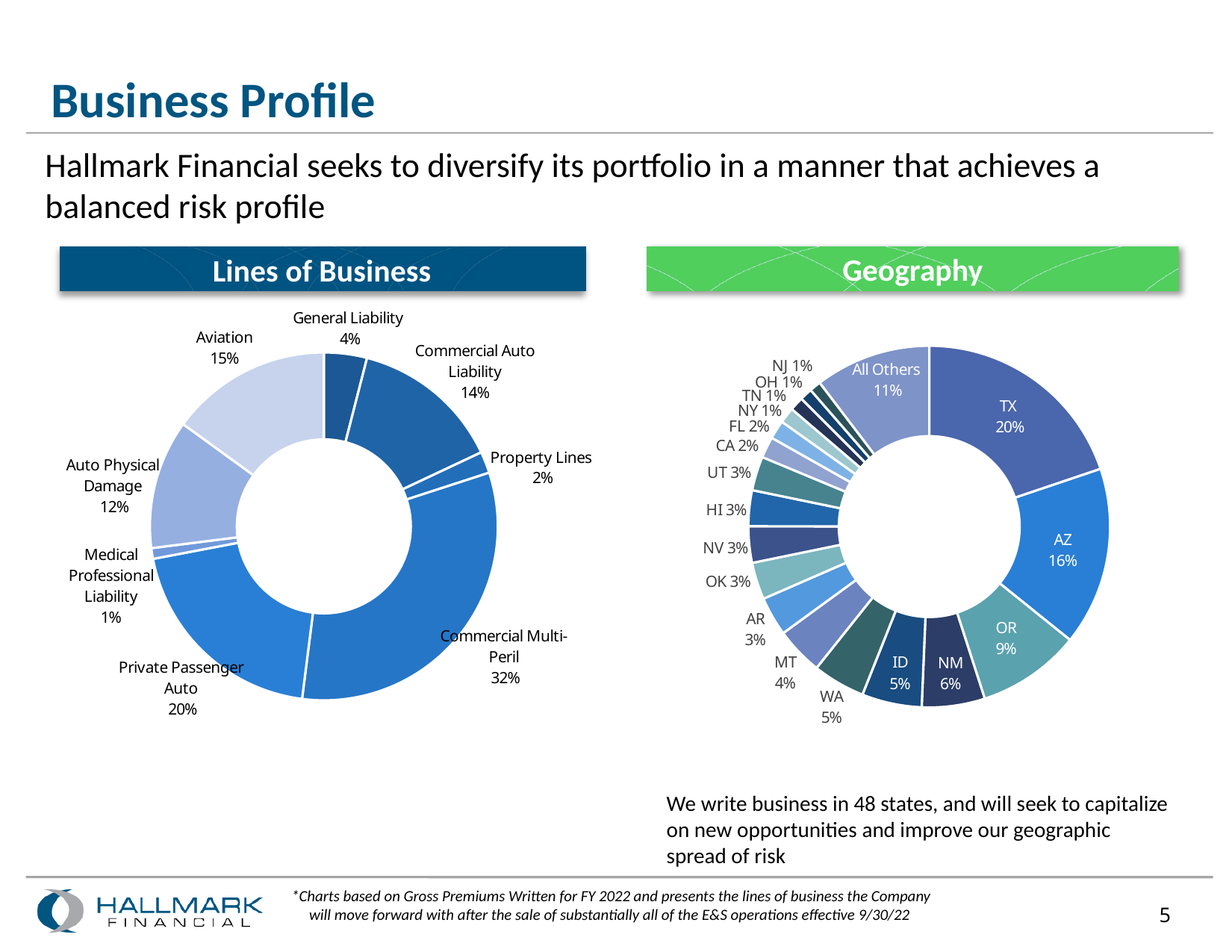
In the Geography chart, what share does OR represent? 9% In the Geography chart, what share does TX represent? 20% In the Lines of Business chart, what share does Commercial Multi-Peril represent? 32% In the Geography chart, which is larger, AZ or All Others? AZ In the Lines of Business chart, which line of business has the smallest share? Medical Professional Liability In the Lines of Business chart, what share does Aviation represent? 15% In the Lines of Business chart, how many lines of business are shown? 8 In the Geography chart, what is the difference in percentage points between TX and AZ? 4 In the Lines of Business chart, what is the difference in percentage points between Private Passenger Auto and Auto Physical Damage? 8 In the Lines of Business chart, which line of business has the largest share? Commercial Multi-Peril In the Geography chart, which state has the largest share? TX What type of chart is the Geography chart? Donut (pie) chart